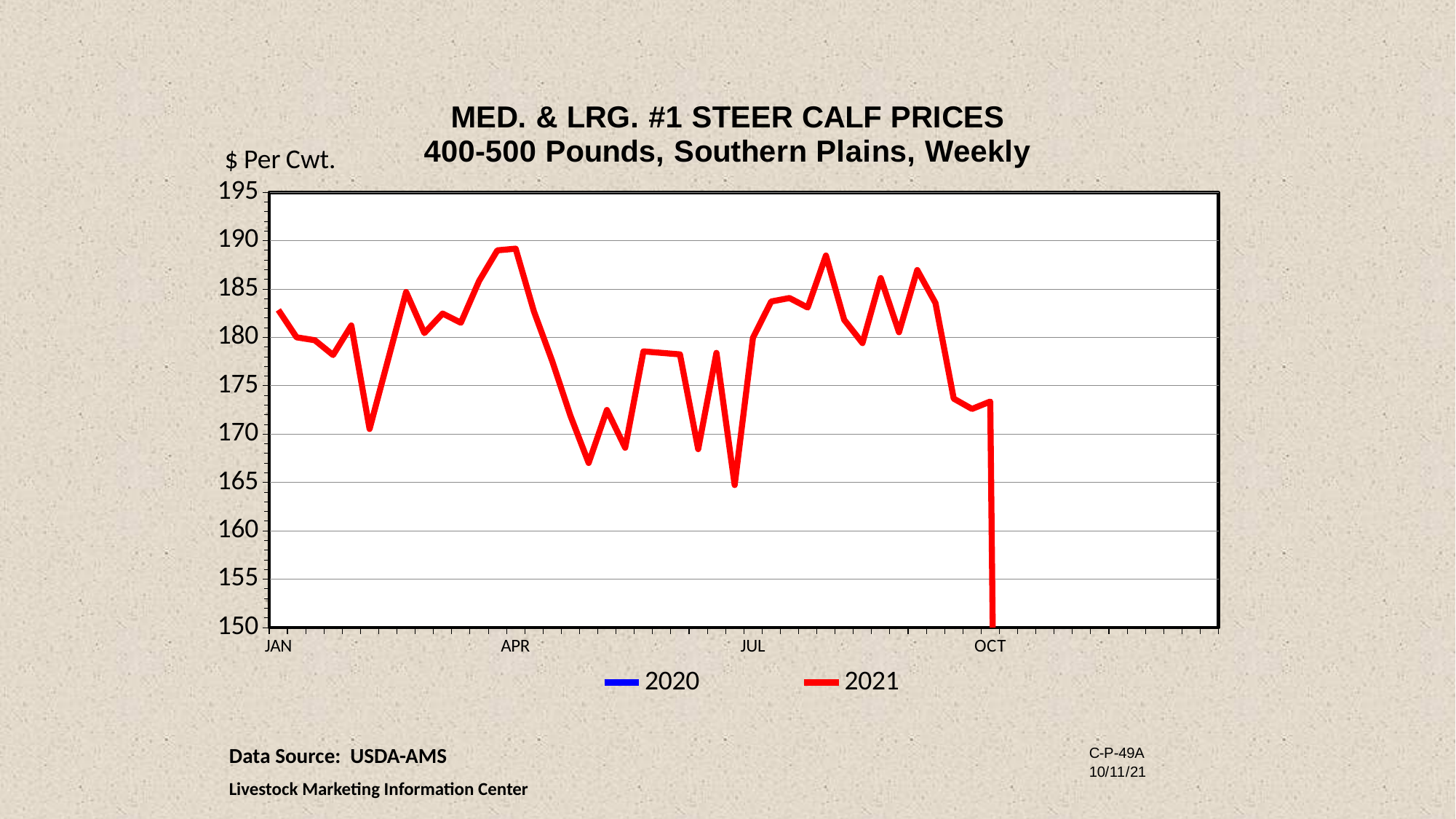
Is the 2021 value at APR greater or less than 185? greater Which is higher for 2021: the value at JAN or the value at APR? APR Is the 2021 value at JAN greater or less than 180? greater What kind of chart is shown on the slide? line chart What is the title of the chart? MED. & LRG. #1 STEER CALF PRICES 400-500 Pounds, Southern Plains, Weekly Does the 2021 line rise or fall between its early-April peak and mid-May? fall How many month labels are shown on the x axis? 4 How many series does the legend list? 2 What colour is the 2021 line? red Is the highest point of the 2021 line greater or less than 185? greater